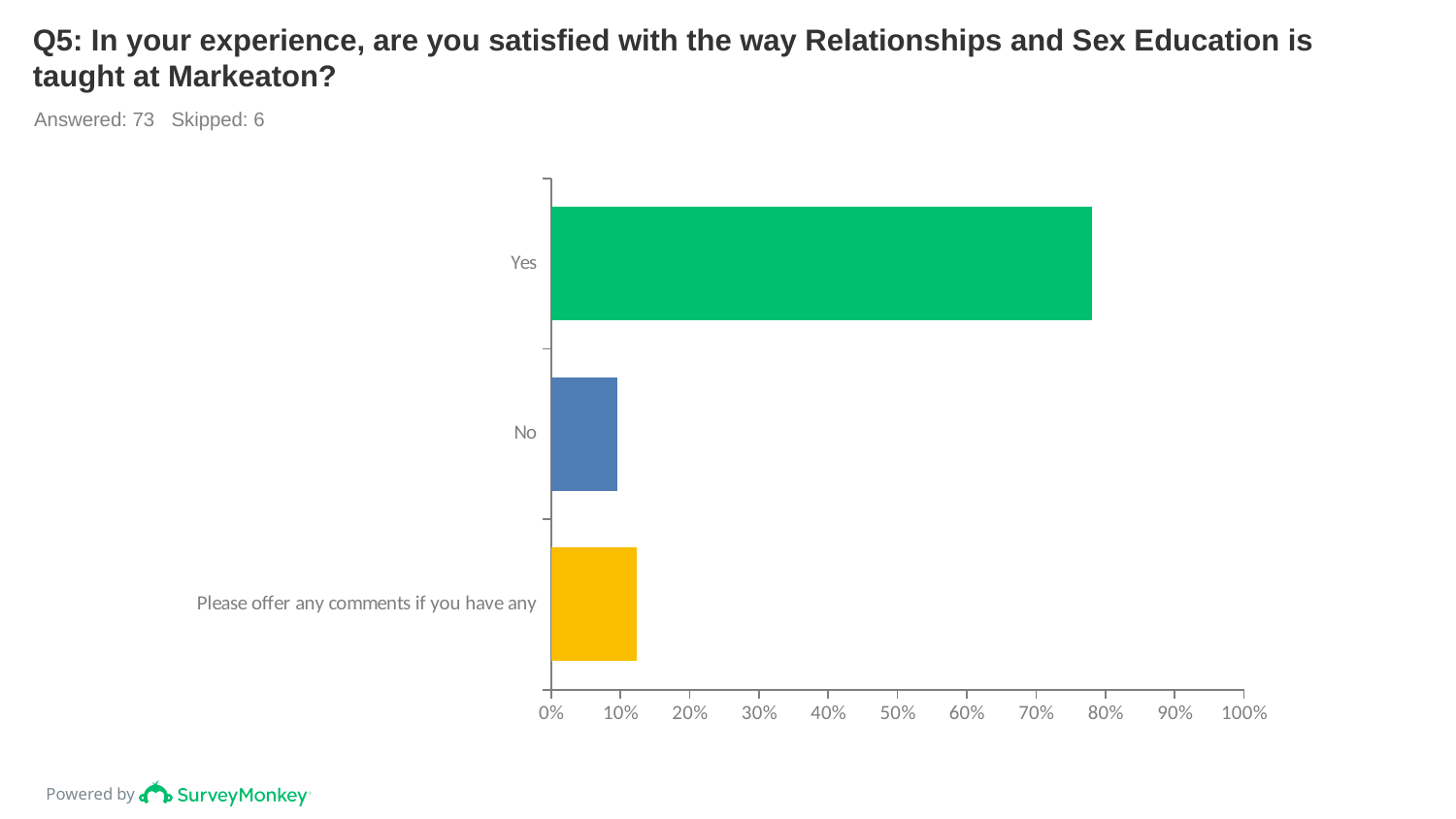
Is the value for Yes greater or less than 50%? greater Is the value for No greater or less than 20%? less Which is larger, the value for Yes or the value for No? Yes Is the value for 'Please offer any comments if you have any' greater or less than 20%? less Which is larger, the value for Yes or the value for 'Please offer any comments if you have any'? Yes What kind of chart is shown on the slide? Bar chart How many respondents answered this question according to the slide? 73 Which category has the highest value in the chart? Yes How many respondents skipped this question according to the slide? 6 How many categories are plotted in the chart? 3